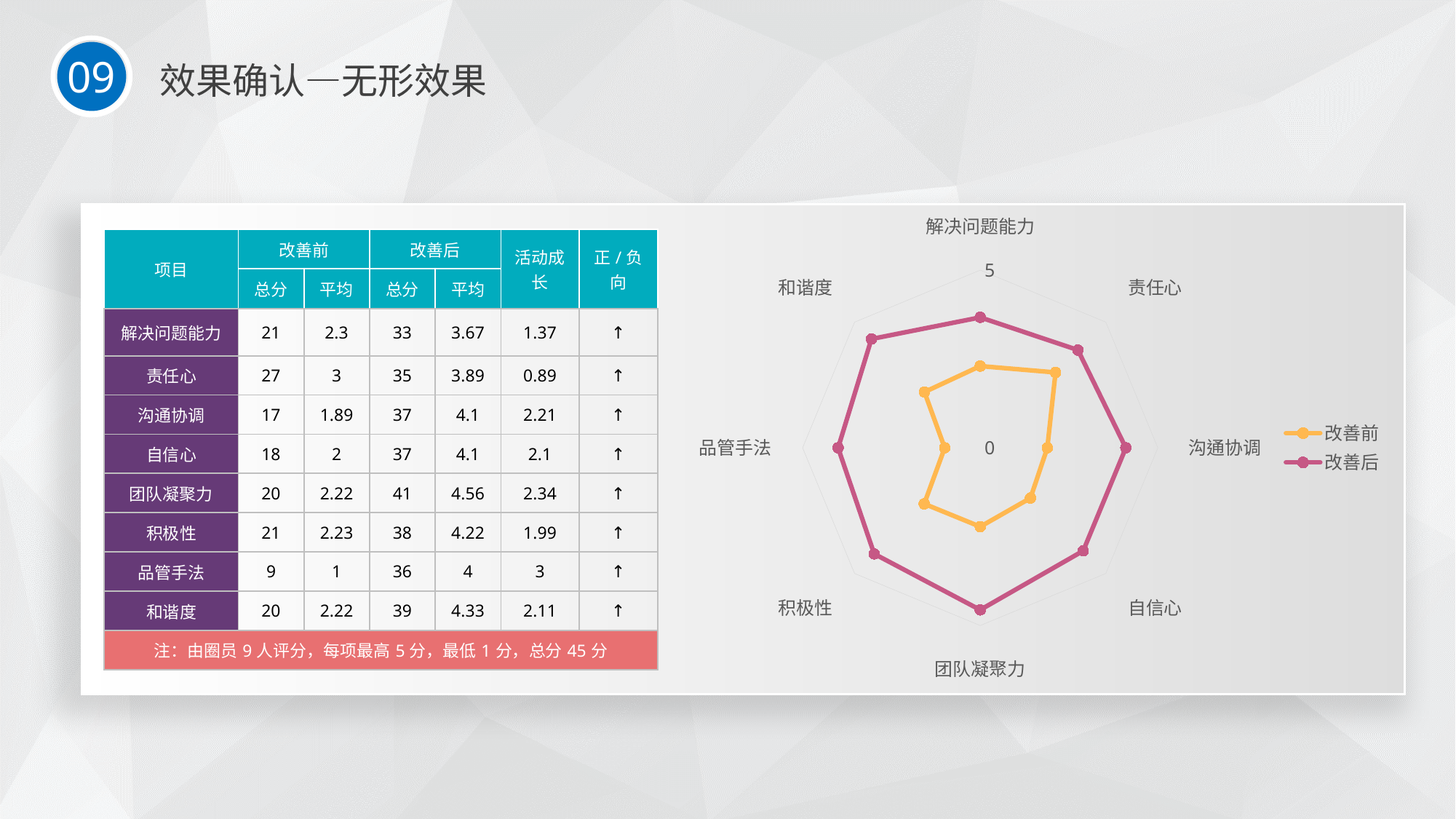
What kind of chart is shown on the right side of the slide? Radar chart What is the 改善后 average value for 团队凝聚力 plotted in the radar chart? 4.56 In the radar chart, is the 改善后 value for 团队凝聚力 larger or smaller than the 改善前 value for 团队凝聚力? Larger Is the 改善前 value for 责任心 in the radar chart greater or less than 5? less Which category has the lowest 改善后 value in the radar chart? 解决问题能力 What are the two series named in the radar chart's legend? 改善前 and 改善后 Which category has the lowest 改善前 value in the radar chart? 品管手法 How many series does the radar chart's legend list? 2 What is the 改善前 average value for 品管手法 plotted in the radar chart? 1 What is the difference between the 改善后 and 改善前 values for 品管手法 in the radar chart? 3 How many categories (axes) does the radar chart have? 8 Which category has the highest 改善前 value in the radar chart? 责任心